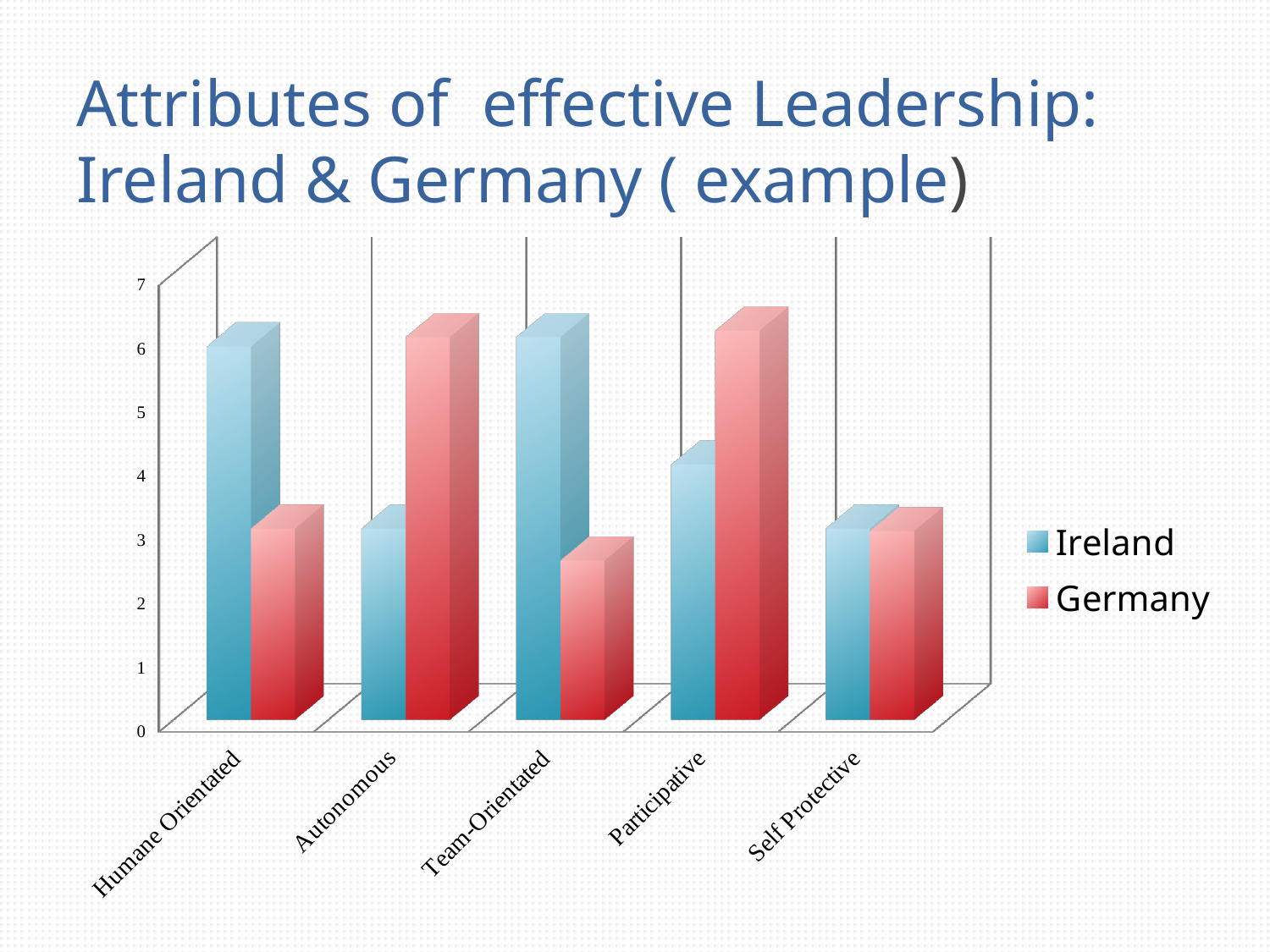
Which colour represents Germany in the chart? red Is the value for Germany on Team-Orientated greater or less than 4? less For Participative, which country has the larger value, Ireland or Germany? Germany For Humane Orientated, which country has the larger value, Ireland or Germany? Ireland How many series does the legend list? 2 Which two countries are listed in the legend? Ireland and Germany How many leadership attribute categories are shown on the x axis? 5 What kind of chart is shown on the slide? bar chart Is the value for Ireland on Humane Orientated greater or less than 5? greater For Team-Orientated, which country has the larger value, Ireland or Germany? Ireland Is the value for Ireland on Autonomous greater or less than 5? less